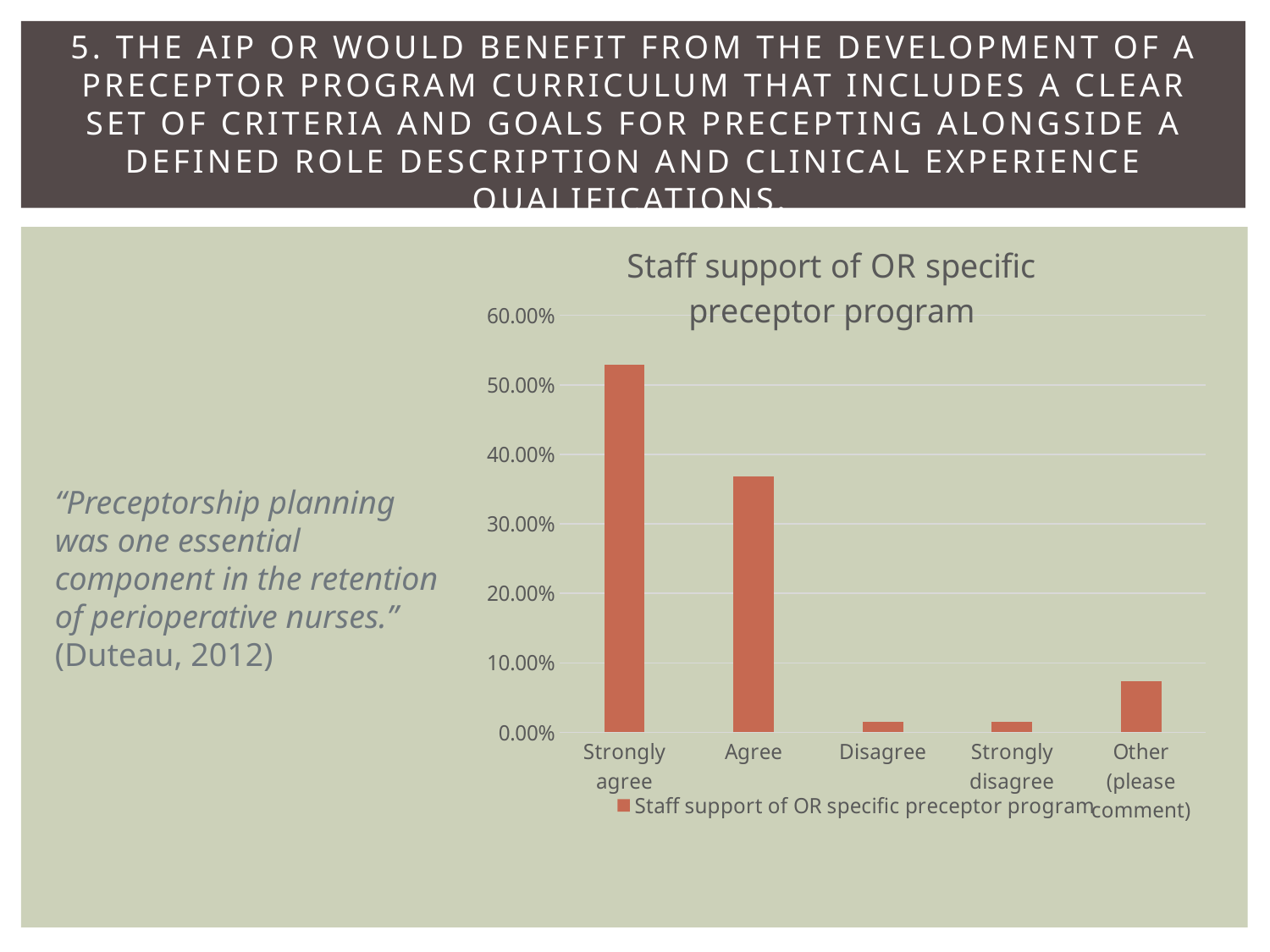
What kind of chart is shown on the slide? bar chart How many categories are shown on the x axis of the chart? 5 Is the value for Agree greater or less than 40.00%? less Is the value for Strongly agree greater or less than 50.00%? greater How many series does the chart's legend list? 1 What is the highest value shown on the chart's vertical axis? 60.00% Which category has the highest value in the chart? Strongly agree Which is larger, the value for Strongly agree or the value for Agree? Strongly agree Is the value for Other (please comment) greater or less than 10.00%? less What is the title of the chart? Staff support of OR specific preceptor program Which is larger, the value for Agree or the value for Other (please comment)? Agree